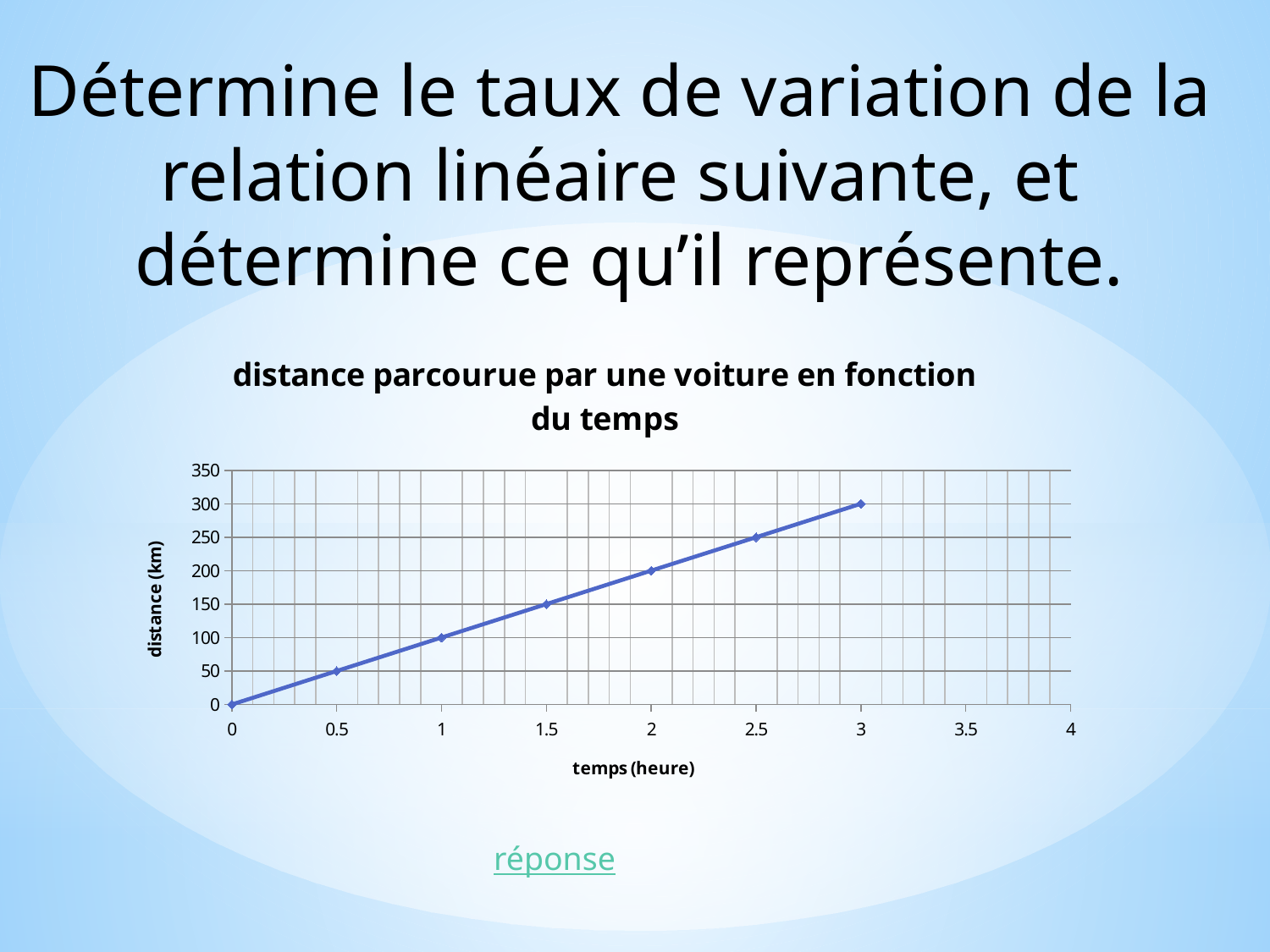
What is the distance at 3 hours? 300 How many data points are plotted on the line? 7 Which is larger, the distance at 1.5 hours or the distance at 2 hours? 2 hours At which time is the distance lowest? 0 What kind of chart is shown on the slide? line chart What is the distance at 1 hour? 100 What is the distance at 2.5 hours? 250 Do the values rise or fall as time increases along the x axis? rise At which time is the distance highest? 3 What is the difference between the distance at 2 hours and the distance at 0.5 hours? 150 What is the label of the vertical axis? distance (km) What is the title of the chart? distance parcourue par une voiture en fonction du temps